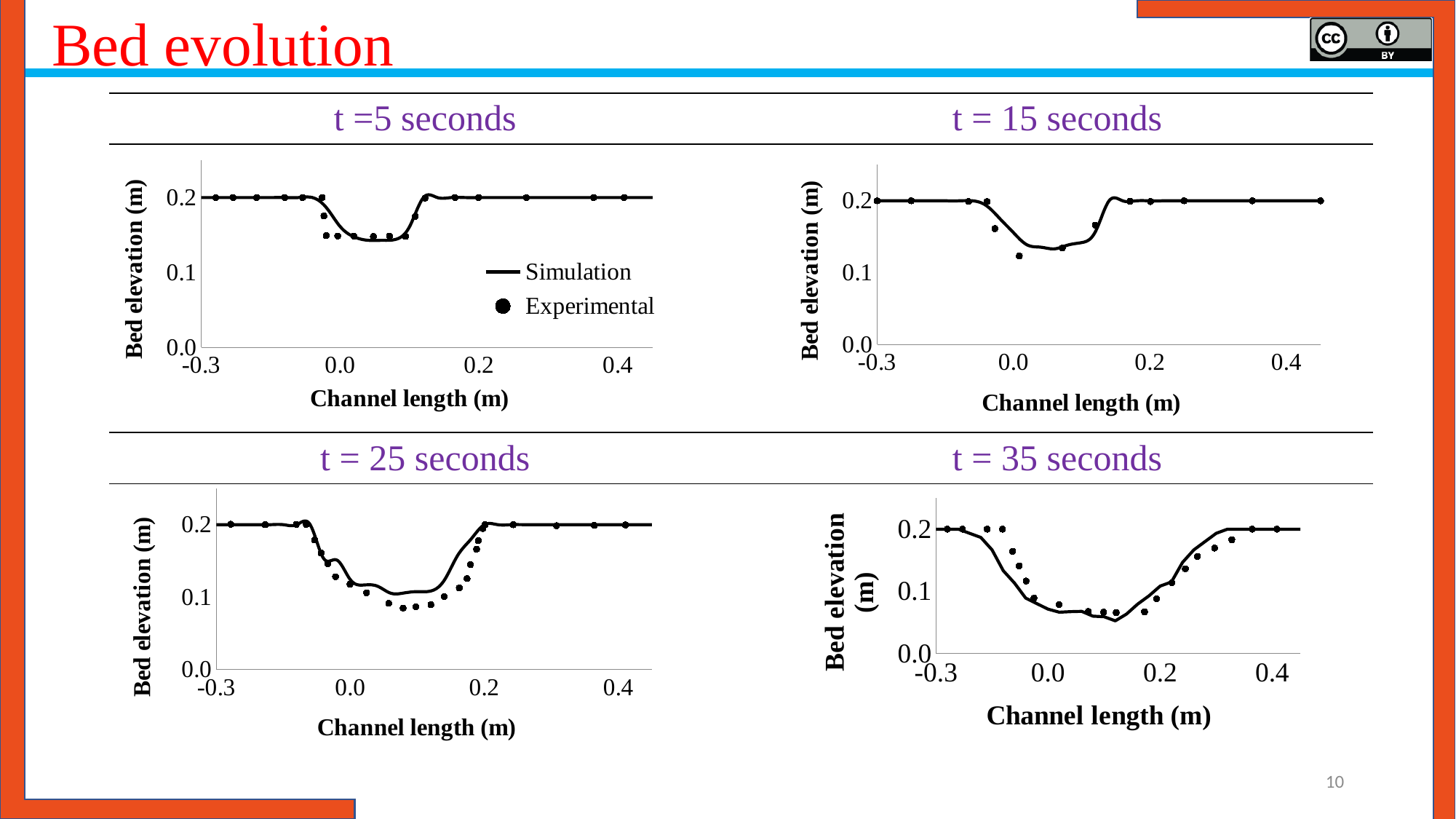
In the "t = 35 seconds" chart, does the simulated bed elevation rise or fall as channel length goes from -0.3 to 0.1? fall What are the two series named in the legend of the "t =5 seconds" chart? Simulation and Experimental Which of the four charts shows the lowest minimum bed elevation? t = 35 seconds How many charts are shown on the slide? 4 In the "t =5 seconds" chart, what is the simulated bed elevation at channel length 0.4? 0.2 In the "t = 25 seconds" chart, is the simulated bed elevation at channel length 0.4 greater or less than 0.1? greater What is the x-axis title of the "t = 15 seconds" chart? Channel length (m) In the "t = 35 seconds" chart, is the lowest simulated bed elevation greater or less than 0.1? less In the "t =5 seconds" chart, is the lowest simulated bed elevation greater or less than 0.1? greater How many series does the legend in the "t =5 seconds" chart list? 2 What kind of chart is shown under "t =5 seconds"? line chart